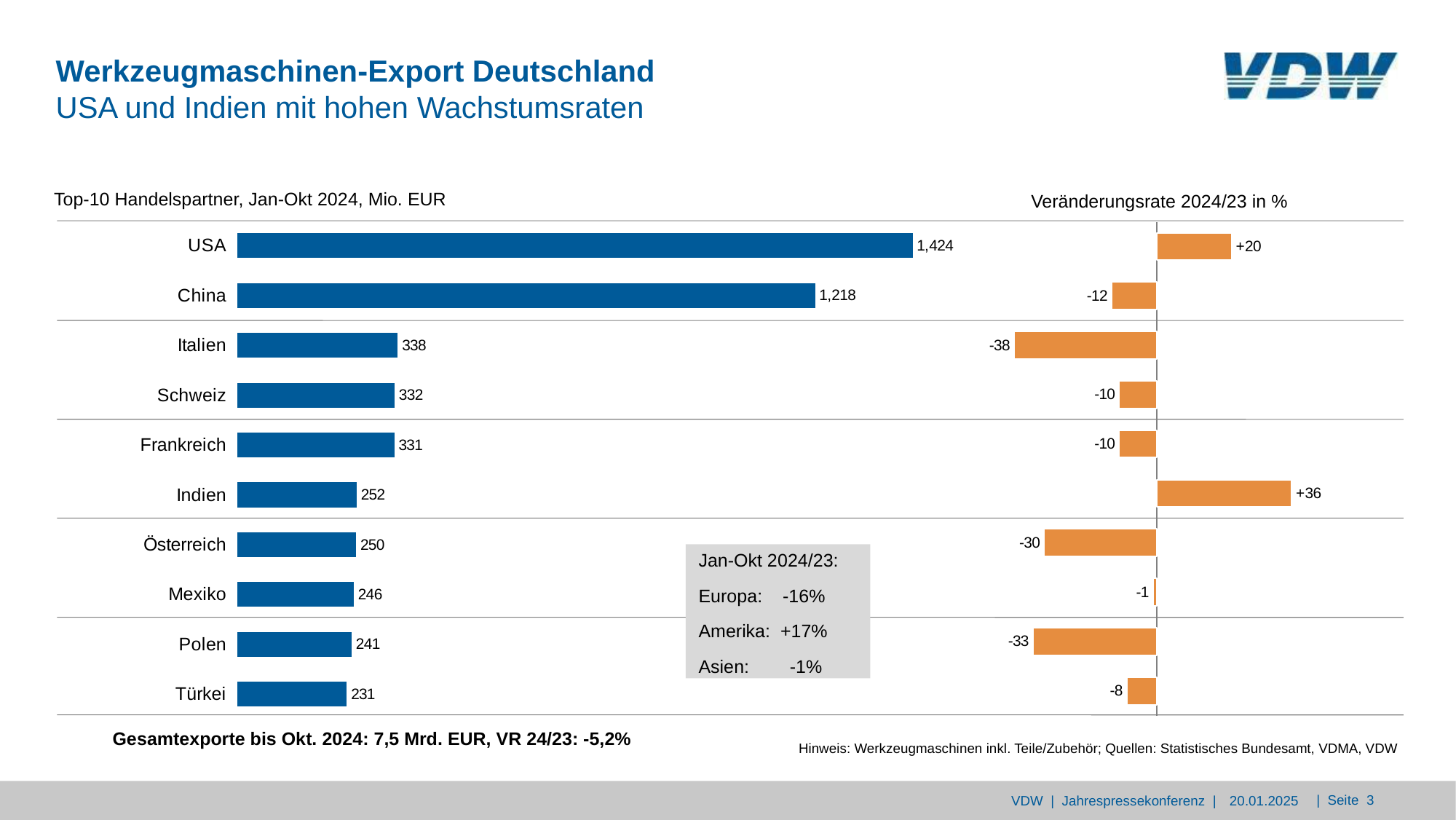
In the 'Veränderungsrate 2024/23 in %' chart, which country has the highest value? Indien In the 'Top-10 Handelspartner, Jan-Okt 2024, Mio. EUR' chart, how many countries are shown? 10 In the 'Veränderungsrate 2024/23 in %' chart, which is larger, the value for Polen or the value for Österreich? Österreich In the 'Top-10 Handelspartner, Jan-Okt 2024, Mio. EUR' chart, which country has the lowest value? Türkei What kind of chart is the 'Top-10 Handelspartner, Jan-Okt 2024, Mio. EUR' chart? bar chart In the 'Veränderungsrate 2024/23 in %' chart, which country has the lowest value? Italien In the 'Veränderungsrate 2024/23 in %' chart, what is the value for Italien? -38 In the 'Top-10 Handelspartner, Jan-Okt 2024, Mio. EUR' chart, what is the value for Mexiko? 246 In the 'Top-10 Handelspartner, Jan-Okt 2024, Mio. EUR' chart, what is the value for China? 1,218 In the 'Top-10 Handelspartner, Jan-Okt 2024, Mio. EUR' chart, which country has the highest value? USA In the 'Veränderungsrate 2024/23 in %' chart, what is the value for Indien? +36 In the 'Top-10 Handelspartner, Jan-Okt 2024, Mio. EUR' chart, what is the difference between the values for USA and China? 206